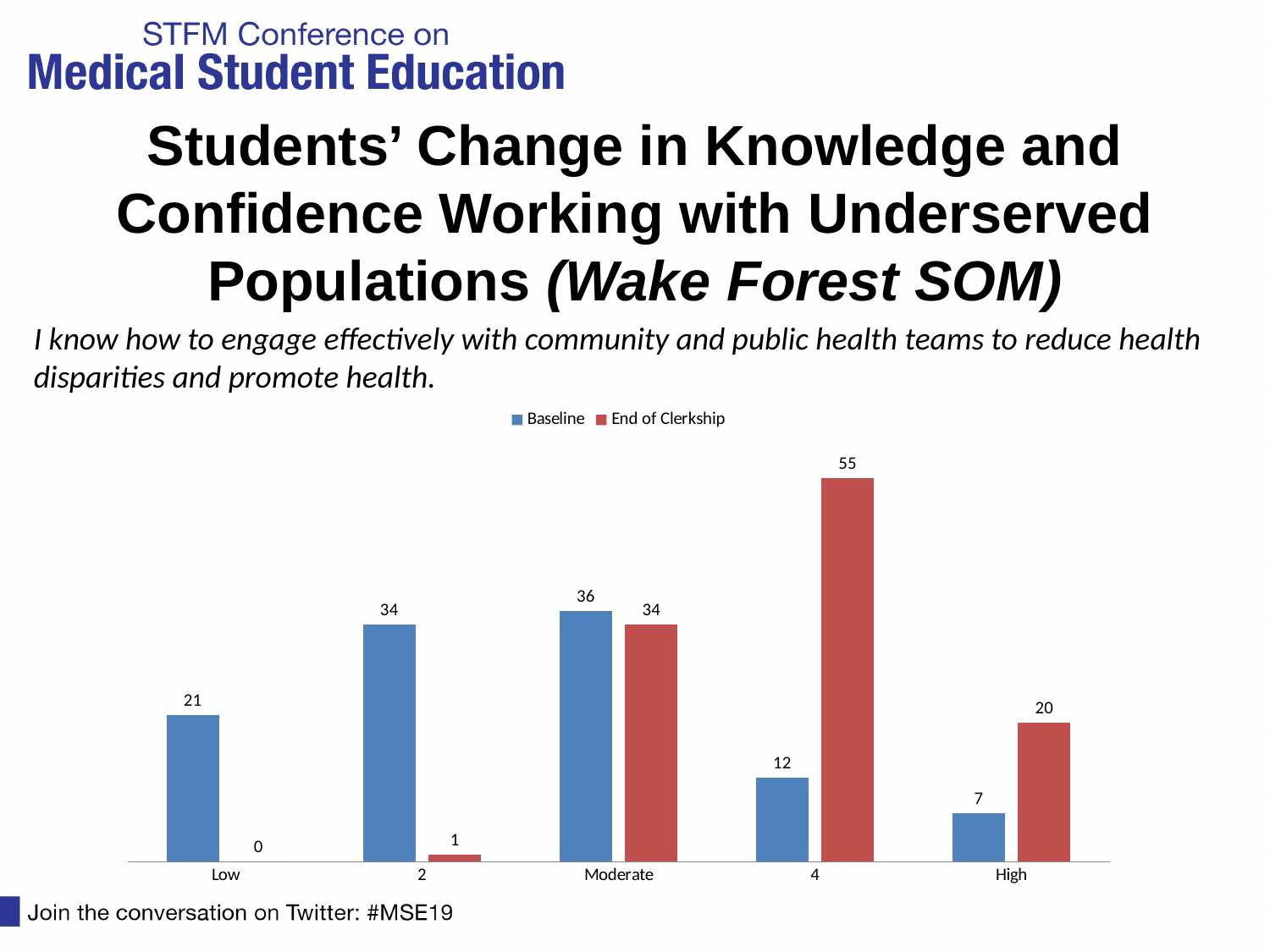
How many categories are shown on the x axis? 5 What is the Baseline value for the Moderate category? 36 How many series does the legend list? 2 What colour are the End of Clerkship bars? Red What kind of chart is shown on the slide? Bar chart Which category has the highest End of Clerkship value? 4 Which is larger for the Moderate category, the Baseline value or the End of Clerkship value? Baseline What is the End of Clerkship value for the 4 category? 55 What is the End of Clerkship value for the High category? 20 Which category has the lowest Baseline value? High What is the difference between the End of Clerkship and Baseline values for the 4 category? 43 What is the Baseline value for the Low category? 21